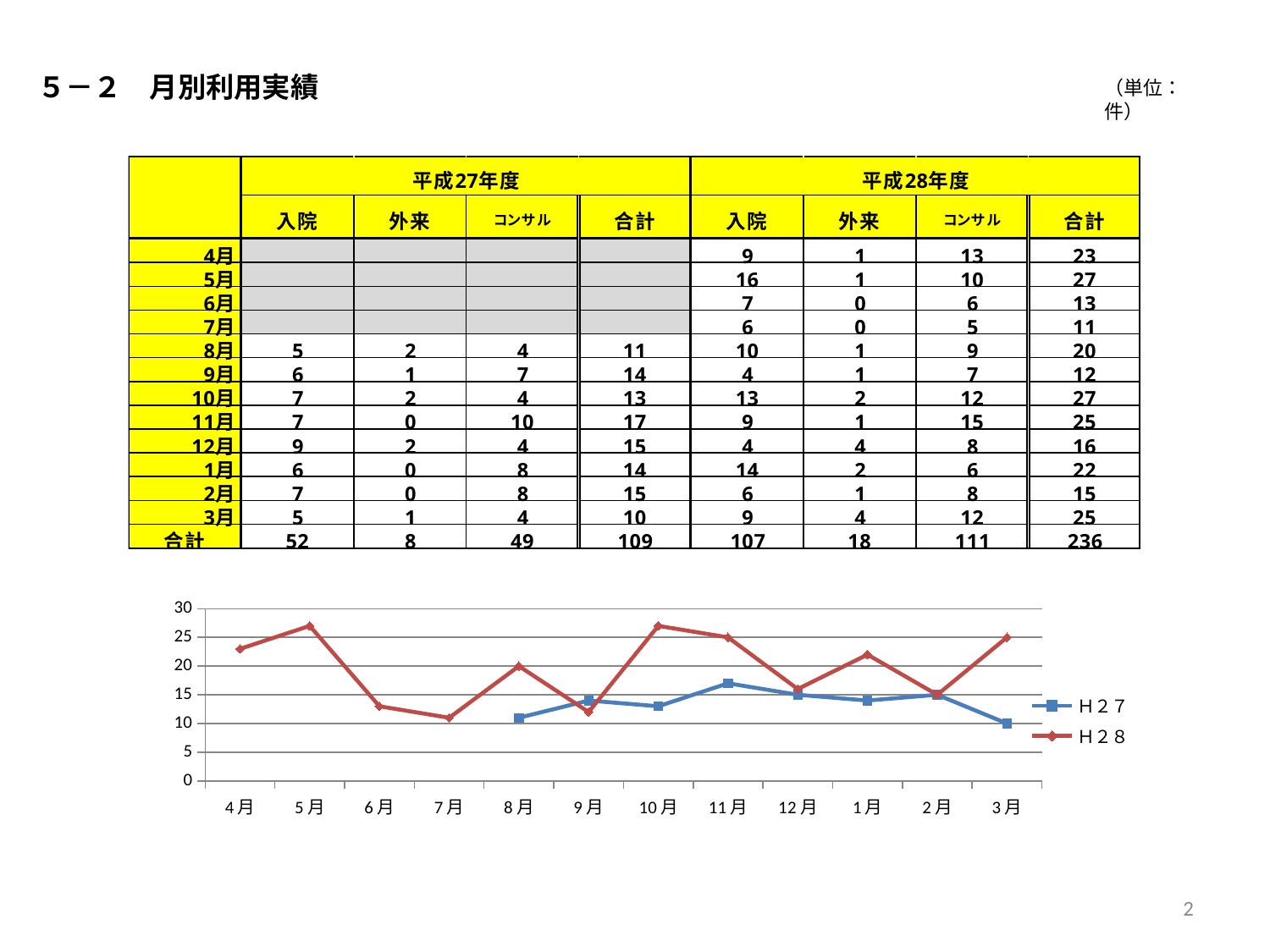
In which month does the H28 line reach its lowest value? 7月 How many series does the chart legend list? 2 In which month does the H27 line reach its highest value? 11月 Does the H28 line rise or fall from 5月 to 7月? fall How many months are shown along the x axis of the chart? 12 In 10月, which series has the larger value, H27 or H28? H28 What kind of chart is shown on the slide? line chart What is the difference between the H28 and H27 values in 10月? 14 Is the H28 value for 4月 greater or less than 20? greater Is the H27 value for 3月 greater or less than 15? less What is the H28 value for 10月 (the 合計 for 平成28年度 in the table)? 27 Which series in the chart has data points for 4月 through 7月? H28